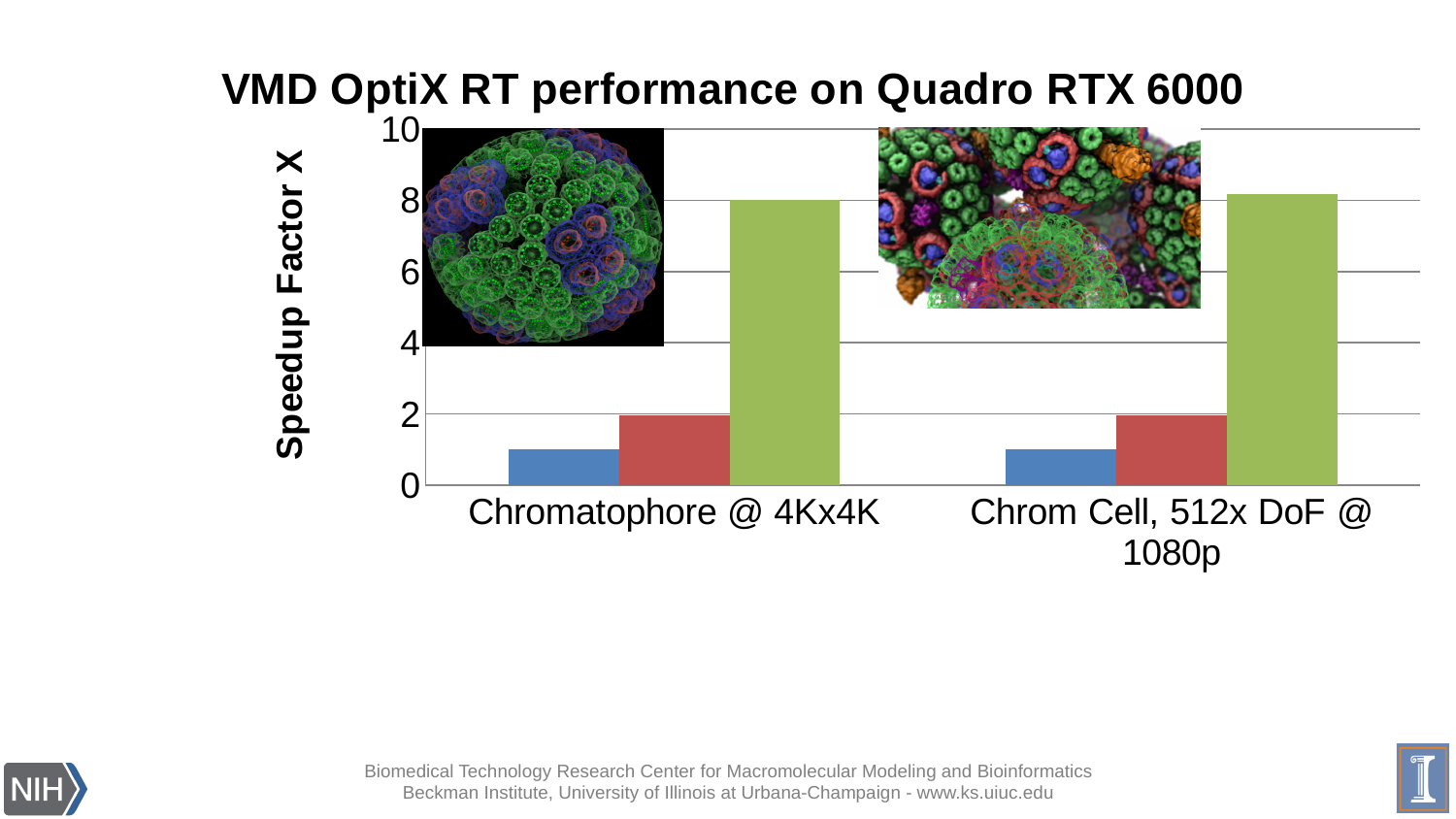
How many categories are shown on the x axis? 2 Is the green bar for 'Chromatophore @ 4Kx4K' greater or less than 10? less What is the highest value shown on the vertical axis? 10 What kind of chart is shown on the slide? bar chart Is the blue bar for 'Chromatophore @ 4Kx4K' greater or less than 2? less Which coloured bar is the shortest for 'Chrom Cell, 512x DoF @ 1080p'? the blue bar For 'Chrom Cell, 512x DoF @ 1080p', which is larger, the red bar or the green bar? the green bar Is the green bar for 'Chrom Cell, 512x DoF @ 1080p' greater or less than 6? greater What is the label of the vertical axis? Speedup Factor X How many bars are plotted for the category 'Chromatophore @ 4Kx4K'? 3 What is the title of the chart? VMD OptiX RT performance on Quadro RTX 6000 Which coloured bar is the tallest for 'Chromatophore @ 4Kx4K'? the green bar